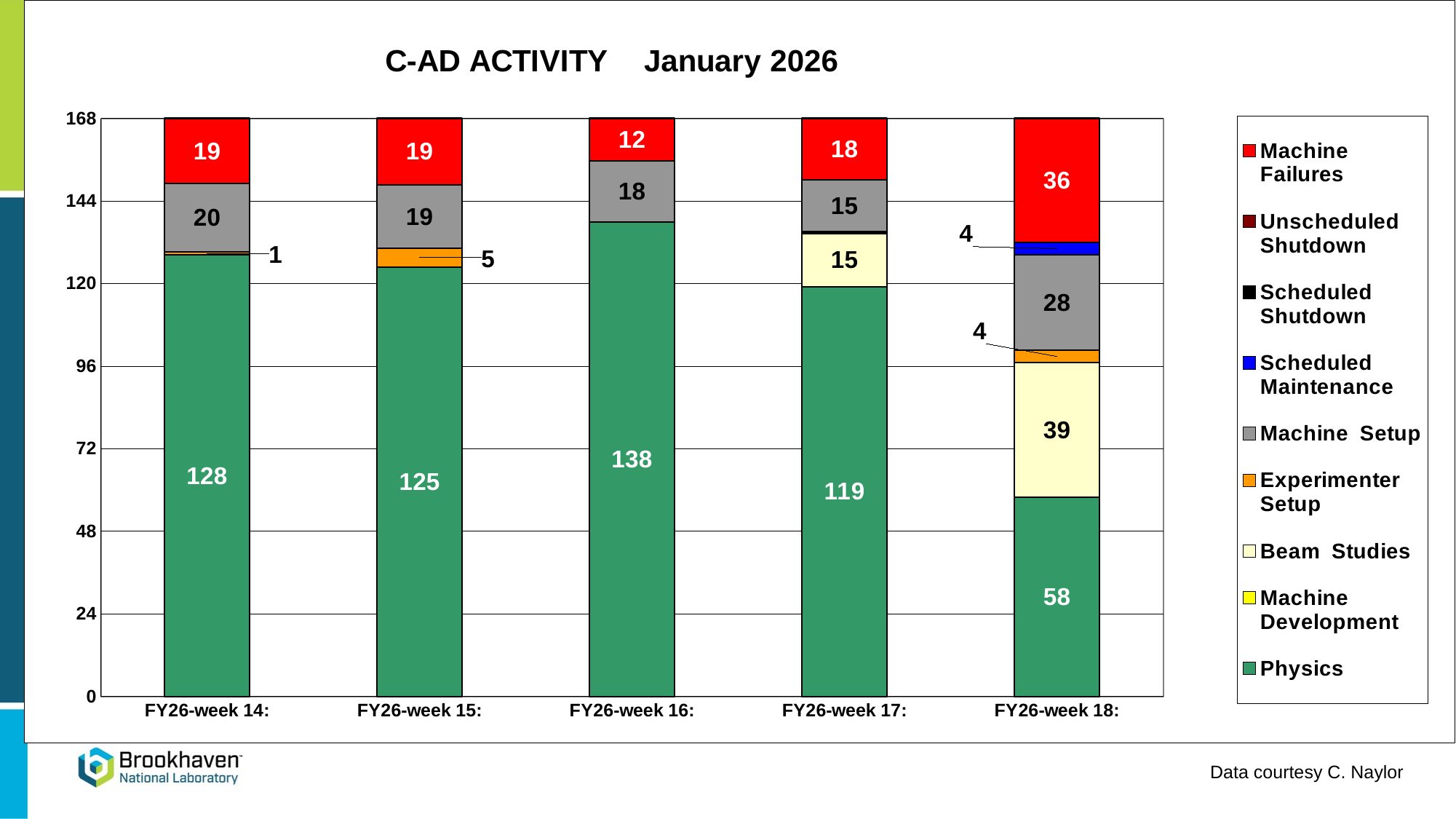
What is the difference between the Physics values for FY26-week 14 and FY26-week 15? 3 Which week has the lowest Physics value? FY26-week 18 How many series does the legend list? 9 Which week has the highest Physics value? FY26-week 16 What kind of chart is shown on the slide? Stacked bar chart What is the Machine Failures value for FY26-week 18? 36 What is the total of the stacked bar for FY26-week 16? 168 What is the Physics value for FY26-week 16? 138 Which week has the larger Machine Setup value, FY26-week 14 or FY26-week 18? FY26-week 18 What is the Beam Studies value for FY26-week 18? 39 What is the title of the chart? C-AD ACTIVITY January 2026 How many weeks (categories) are shown on the x axis? 5